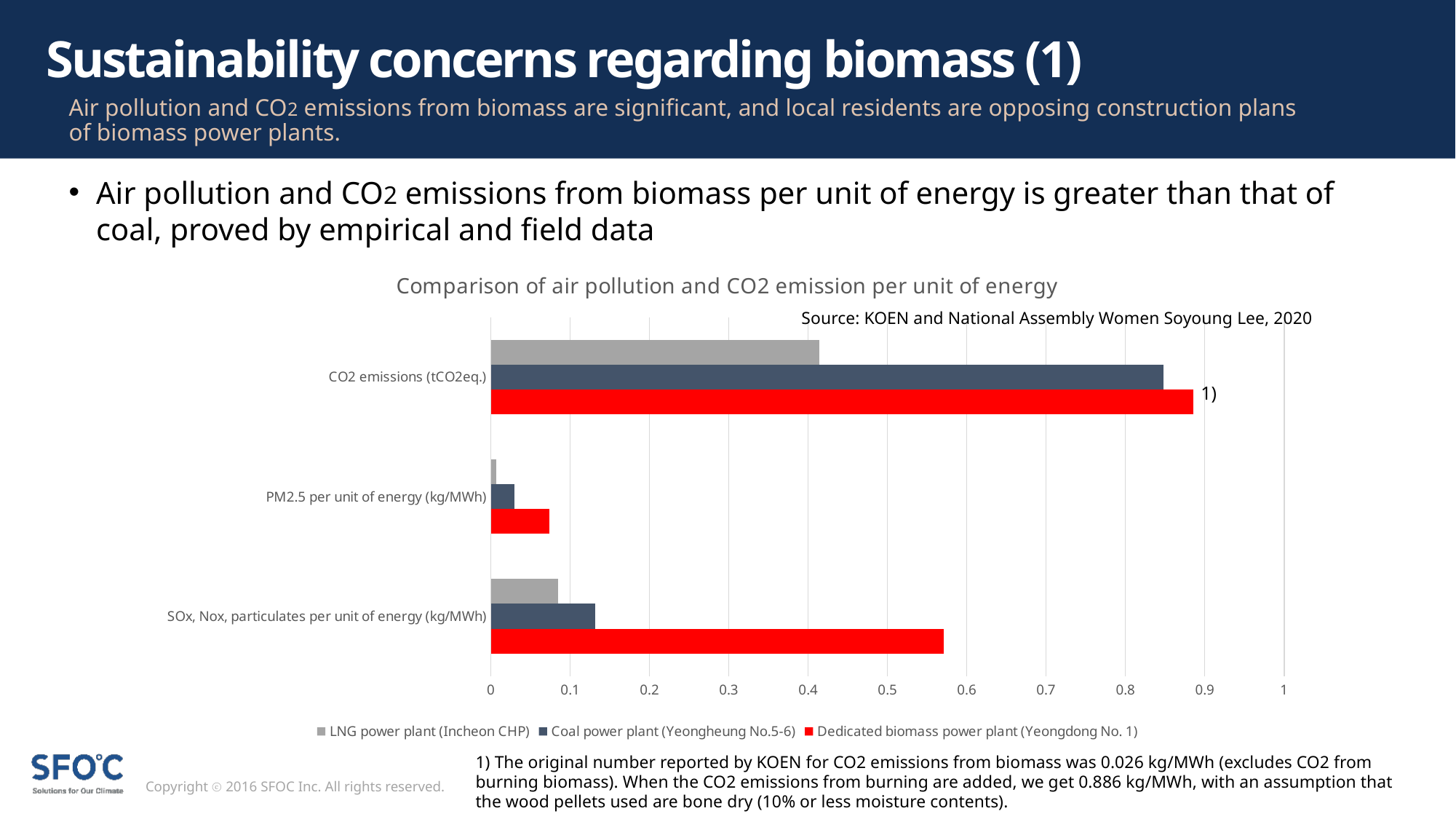
Is the value for the Coal power plant (Yeongheung No.5-6) in the SOx, Nox, particulates per unit of energy (kg/MWh) category greater or less than 0.1? greater In the SOx, Nox, particulates per unit of energy (kg/MWh) category, which is larger: the Coal power plant or the Dedicated biomass power plant? Dedicated biomass power plant (Yeongdong No. 1) How many series does the chart legend list? 3 In the CO2 emissions (tCO2eq.) category, which is larger: the LNG power plant or the Coal power plant? Coal power plant (Yeongheung No.5-6) In the PM2.5 per unit of energy (kg/MWh) category, which series has the lowest value? LNG power plant (Incheon CHP) What is the title of the chart? Comparison of air pollution and CO2 emission per unit of energy How many categories are plotted on the y axis of the chart? 3 Is the value for the Dedicated biomass power plant in the SOx, Nox, particulates per unit of energy (kg/MWh) category greater or less than 0.5? greater What kind of chart is shown on the slide? bar chart Is the value for the Coal power plant (Yeongheung No.5-6) in the CO2 emissions (tCO2eq.) category greater or less than 0.8? greater For the Dedicated biomass power plant (Yeongdong No. 1) series, which category has the highest value? CO2 emissions (tCO2eq.)